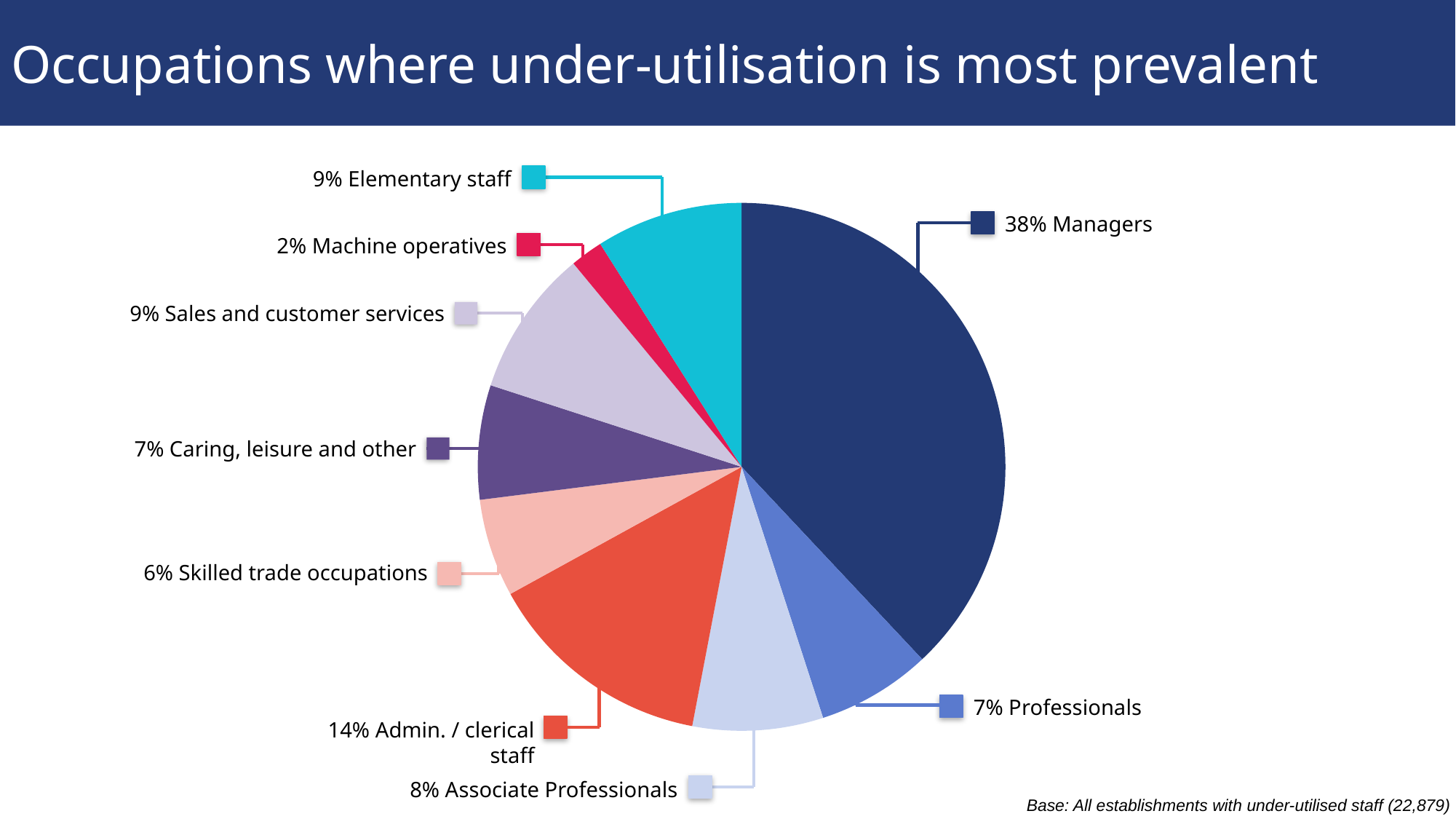
Which occupation has the largest slice of the pie? Managers Which occupation has the smallest slice of the pie? Machine operatives Which is larger, the share for Elementary staff or the share for Skilled trade occupations? Elementary staff What kind of chart is shown on the slide? pie chart What is the base stated for the chart? All establishments with under-utilised staff (22,879) What is the title of the chart? Occupations where under-utilisation is most prevalent What share of the pie is Machine operatives? 2% What is the difference in percentage points between Managers and Admin. / clerical staff? 24 How many slices does the pie chart have? 9 What share of the pie is Associate Professionals? 8% What share of the pie is Managers? 38% What share of the pie is Admin. / clerical staff? 14%